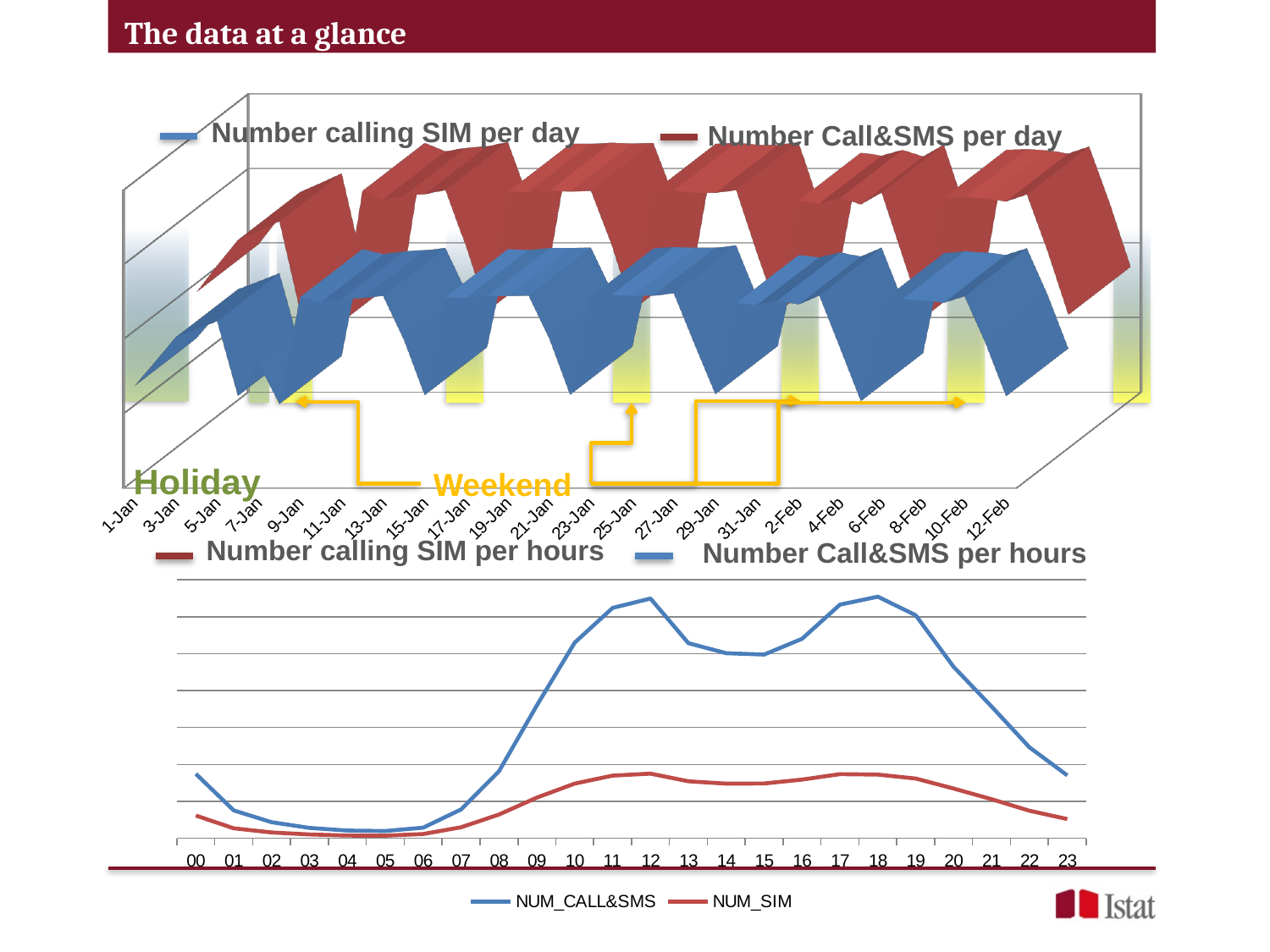
How many series does the top chart (per day) show? 2 In the bottom chart (per hours), which series is drawn in blue? NUM_CALL&SMS How many date labels are shown on the x axis of the top chart (per day)? 22 How many hour categories are shown on the x axis of the bottom chart (per hours)? 24 How many series does the legend of the bottom chart (per hours) list? 2 In the bottom chart (per hours), is the NUM_CALL&SMS value at 12 larger or smaller than at 15? Larger What kind of chart is the bottom chart (per hours)? Line chart What is the first date label on the x axis of the top chart (per day)? 1-Jan In the bottom chart (per hours), does the NUM_CALL&SMS line rise or fall between 18 and 23? Fall In the bottom chart (per hours), which series is higher at hour 12, NUM_CALL&SMS or NUM_SIM? NUM_CALL&SMS In the bottom chart (per hours), does the NUM_CALL&SMS line rise or fall between 06 and 11? Rise